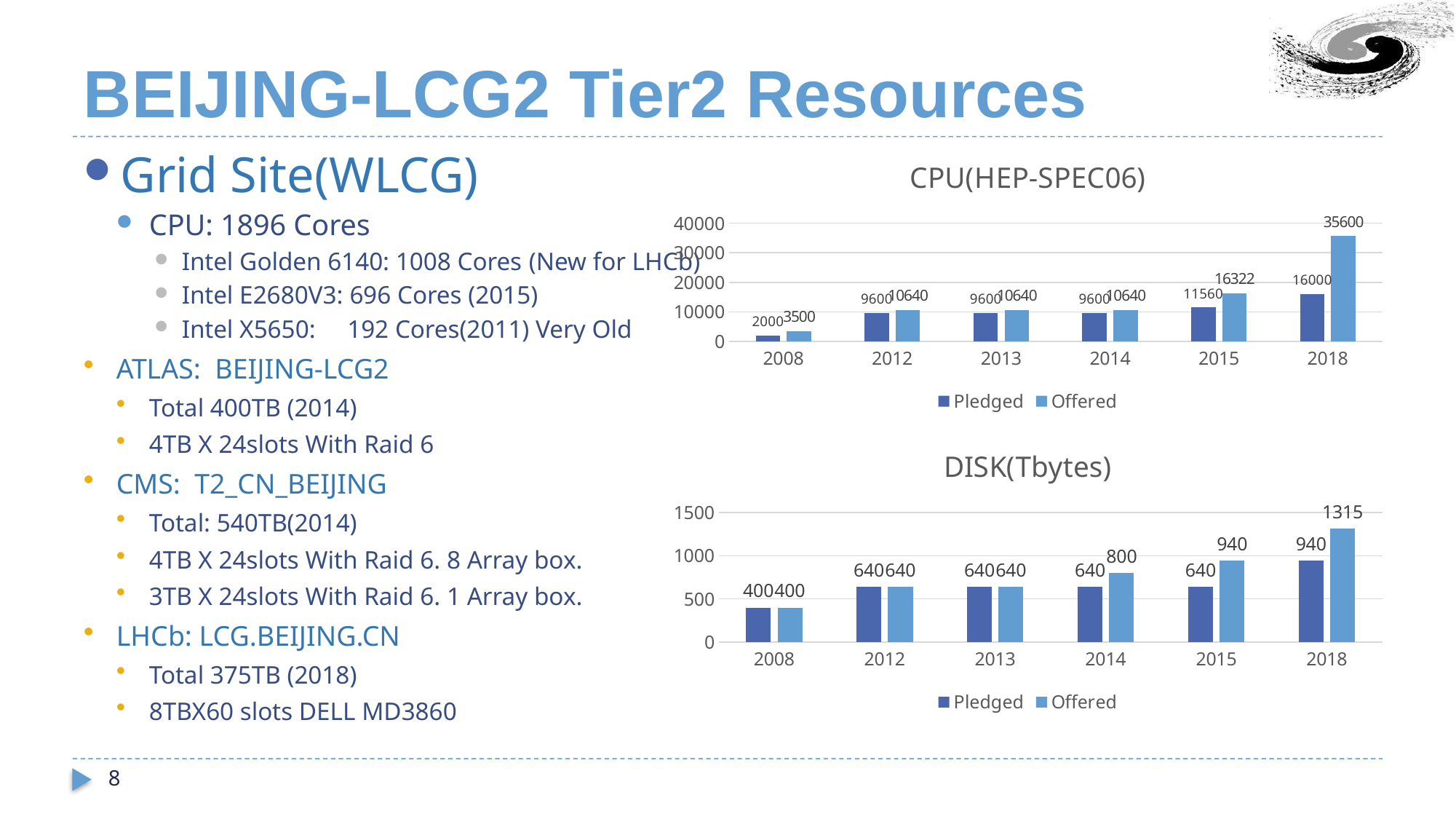
In the DISK(Tbytes) chart, which year has the highest Offered value? 2018 In the DISK(Tbytes) chart, is the Offered value for 2014 larger than the Pledged value for 2014? Yes In the CPU(HEP-SPEC06) chart, what is the Pledged value for 2015? 11560 In the DISK(Tbytes) chart, what is the difference between the Offered and Pledged values for 2015? 300 In the CPU(HEP-SPEC06) chart, what is the Offered value for 2018? 35600 In the DISK(Tbytes) chart, what is the Offered value for 2018? 1315 In the CPU(HEP-SPEC06) chart, which year has the lowest Pledged value? 2008 In the CPU(HEP-SPEC06) chart, what is the difference between the Offered and Pledged values for 2018? 19600 In the DISK(Tbytes) chart, how many years are shown on the x axis? 6 What kind of chart is the DISK(Tbytes) chart? bar chart In the DISK(Tbytes) chart, what is the Pledged value for 2014? 640 In the CPU(HEP-SPEC06) chart, how many series does the legend list? 2